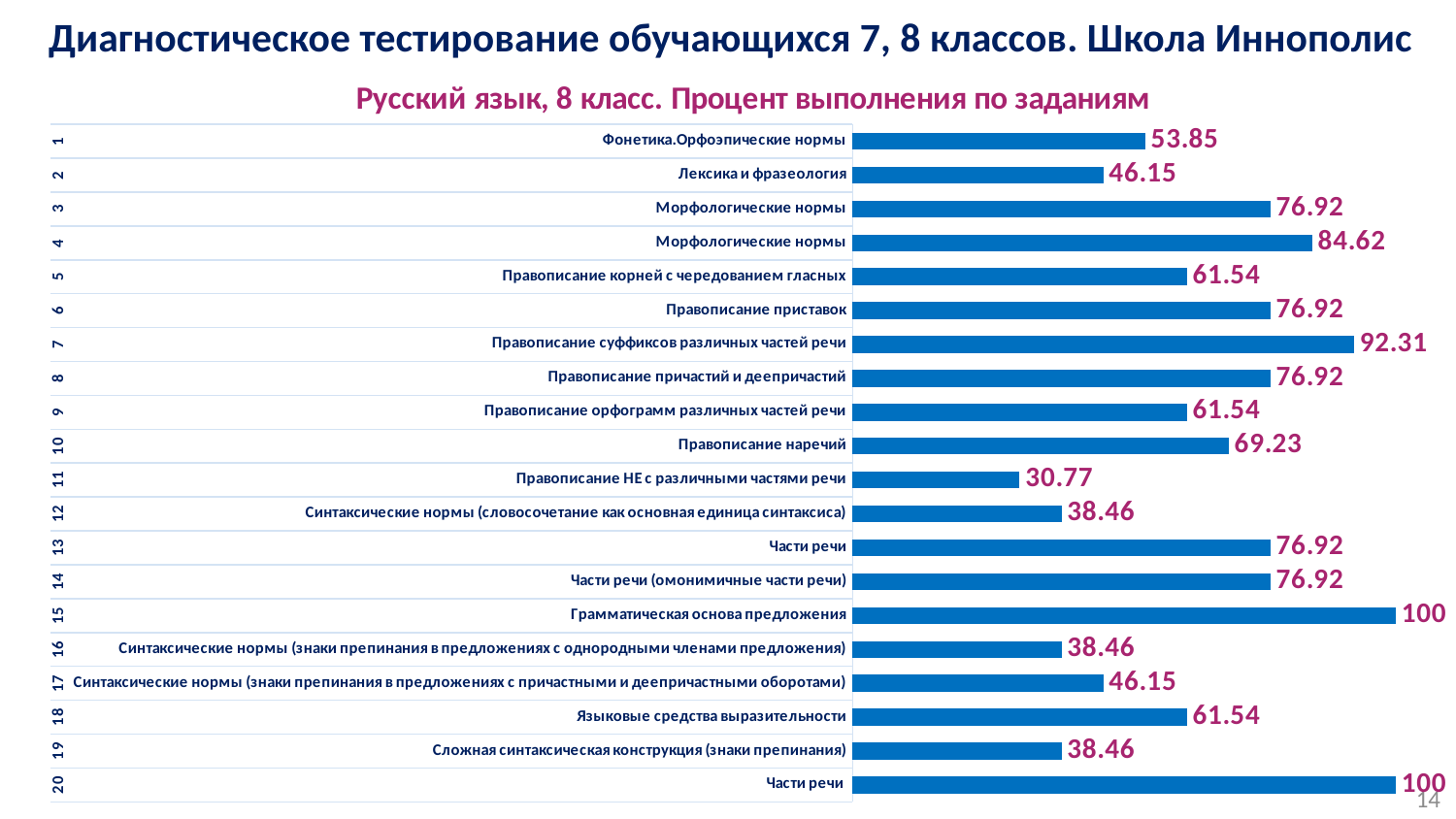
How many tasks are shown on the chart? 20 What kind of chart is shown on the slide? Bar chart What is the difference between the value for task 7 (92.31) and task 11 (30.77)? 61.54 What is the value for task 18, Языковые средства выразительности? 61.54 What is the value for task 10, Правописание наречий? 69.23 What is the highest value shown on the chart? 100 What is the difference between the value for task 10 (69.23) and task 1 (53.85)? 15.38 What is the value for task 4, Морфологические нормы? 84.62 What is the value for task 11, Правописание НЕ с различными частями речи? 30.77 Which is larger: the value for task 5, Правописание корней с чередованием гласных, or task 12, Синтаксические нормы (словосочетание как основная единица синтаксиса)? Task 5, Правописание корней с чередованием гласных What is the value for task 7, Правописание суффиксов различных частей речи? 92.31 Which task has the lowest value? Task 11, Правописание НЕ с различными частями речи